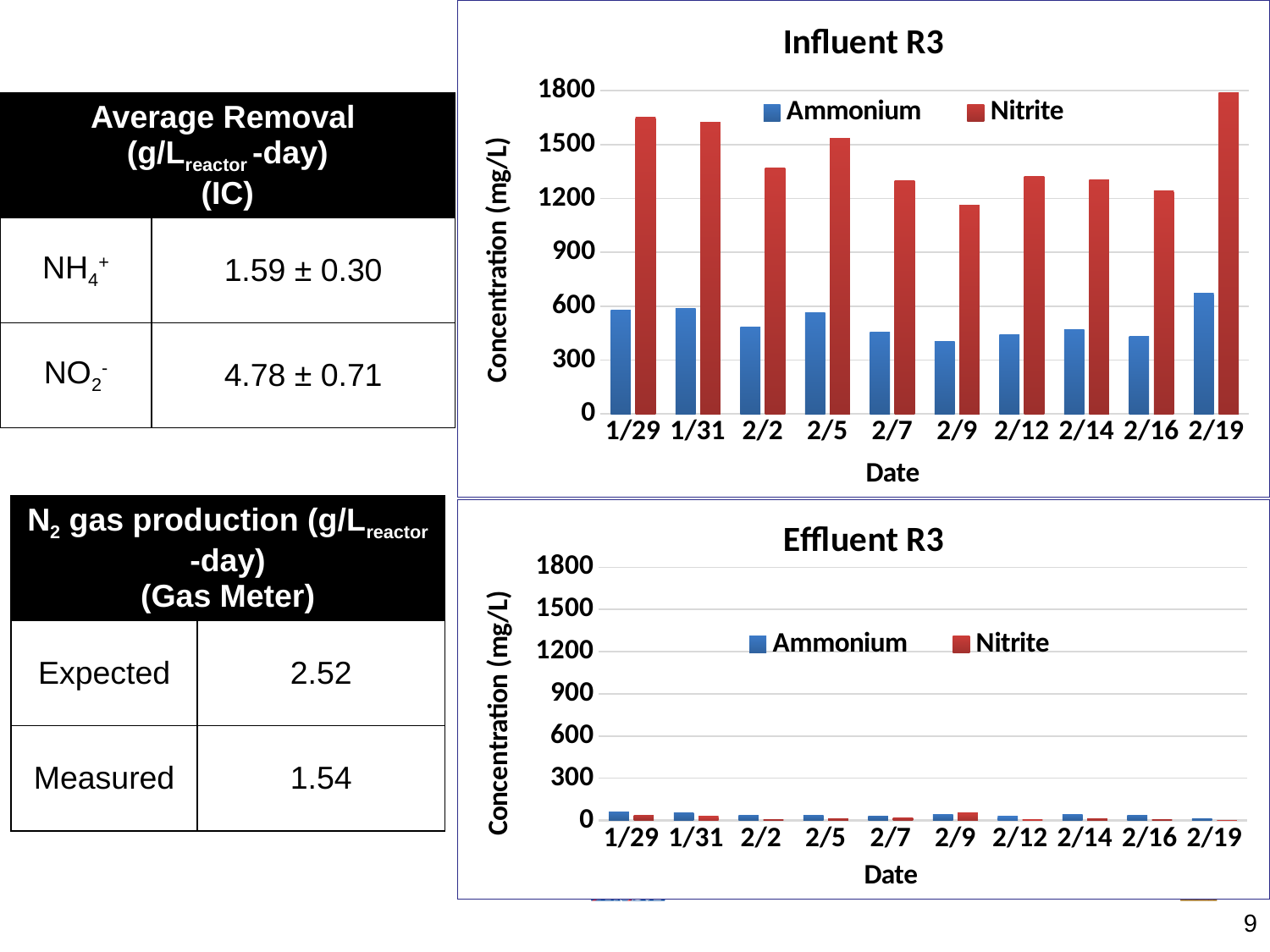
What kind of chart is the Influent R3 chart? bar chart In the Influent R3 chart, on which date is the Nitrite concentration lowest? 2/9 In the Influent R3 chart, is the Nitrite value for 1/29 greater or less than 1500? greater What is the y-axis label of the Effluent R3 chart? Concentration (mg/L) In the Influent R3 chart, which is larger on 2/5, Ammonium or Nitrite? Nitrite In the Influent R3 chart, is the Nitrite value for 2/2 greater or less than 1200? greater In the Influent R3 chart, on which date is the Nitrite concentration highest? 2/19 How many dates are shown on the x axis of the Influent R3 chart? 10 In the Influent R3 chart, is the Ammonium value for 2/19 greater or less than 600? greater In the Influent R3 chart, on which date is the Ammonium concentration highest? 2/19 How many series does the legend of the Effluent R3 chart list? 2